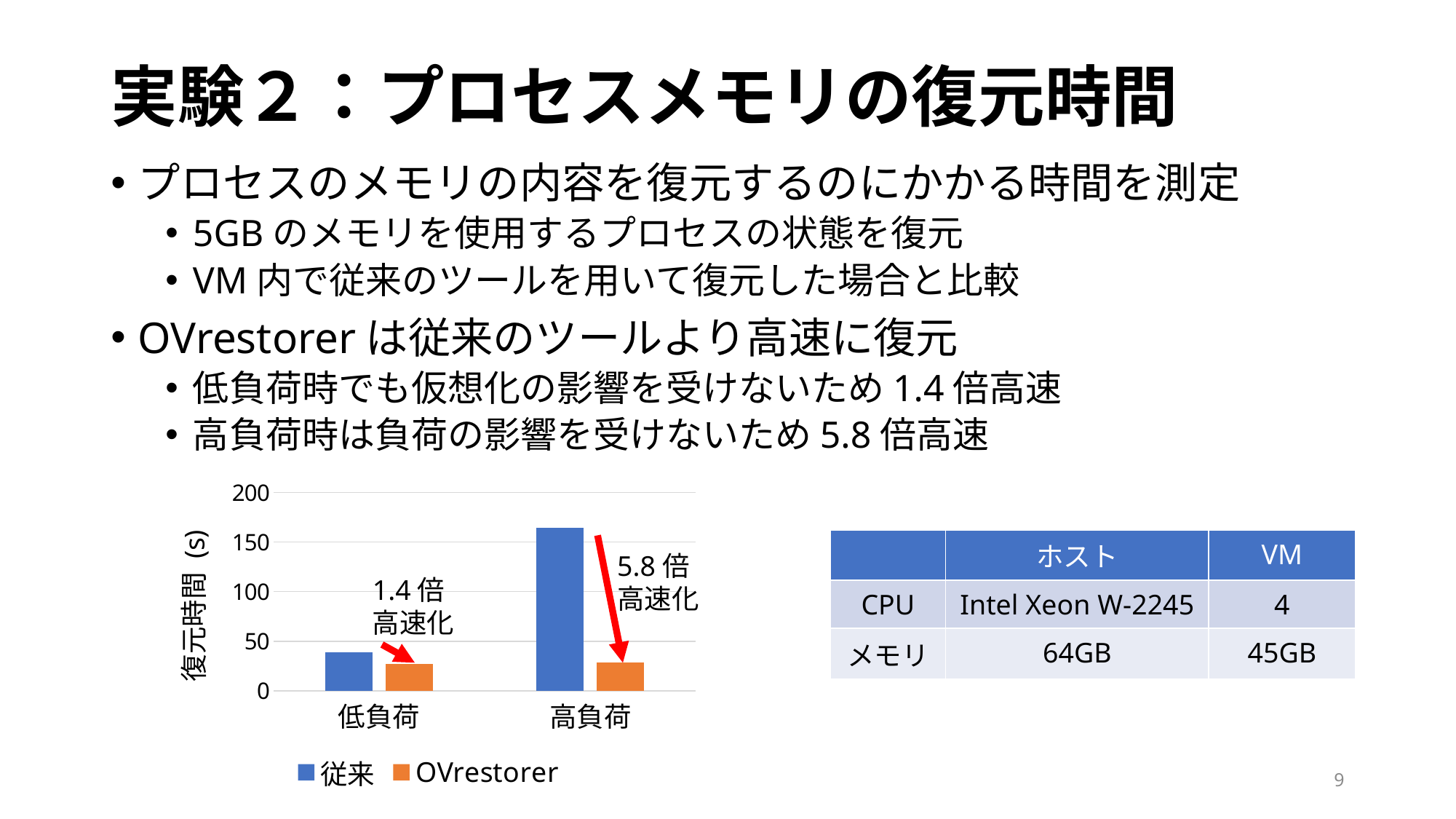
What kind of chart is shown on the slide? bar chart Is the value for OVrestorer at 低負荷 greater or less than 50? less Is the value for 従来 at 高負荷 greater or less than 150? greater What is the label of the y axis of the chart? 復元時間 (s) At 高負荷, which is larger: 従来 or OVrestorer? 従来 Which series has the highest bar in the chart? 従来 (高負荷) How many series does the chart legend list? 2 What speed-up factor is annotated next to the 高負荷 bars in the chart? 5.8 倍高速化 Is the value for 従来 at 低負荷 greater or less than 50? less How many categories are shown on the x axis of the chart? 2 At 低負荷, which is larger: 従来 or OVrestorer? 従来